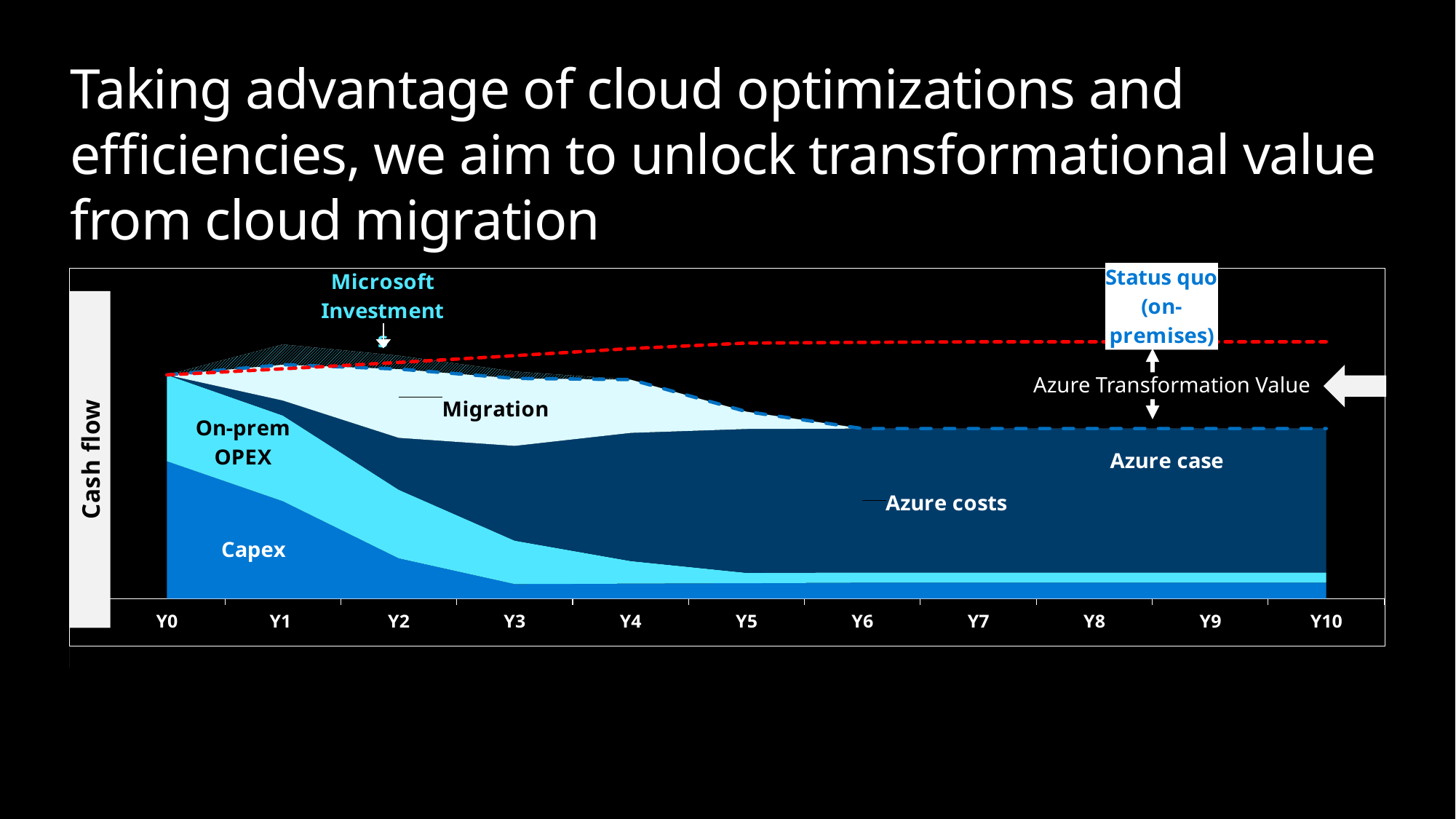
Is the Migration area larger at Y3 or at Y8? Y3 Does the On-prem OPEX area rise or fall from Y0 to Y3? Fall How many year points are labelled along the x axis of the chart? 11 What kind of chart is shown on the slide? Stacked area chart What is the gap between the Status quo line and the Azure case line labelled as? Azure Transformation Value Which area is at the bottom of the stack in the chart? Capex What is the label on the vertical axis of the chart? Cash flow What is the first category on the x axis of the chart? Y0 What does the red dashed line in the chart represent? Status quo (on-premises) Does the Capex area rise or fall from Y0 to Y3? Fall Does the red dashed Status quo (on-premises) line rise or fall from Y0 to Y10? Rise What is the last category on the x axis of the chart? Y10